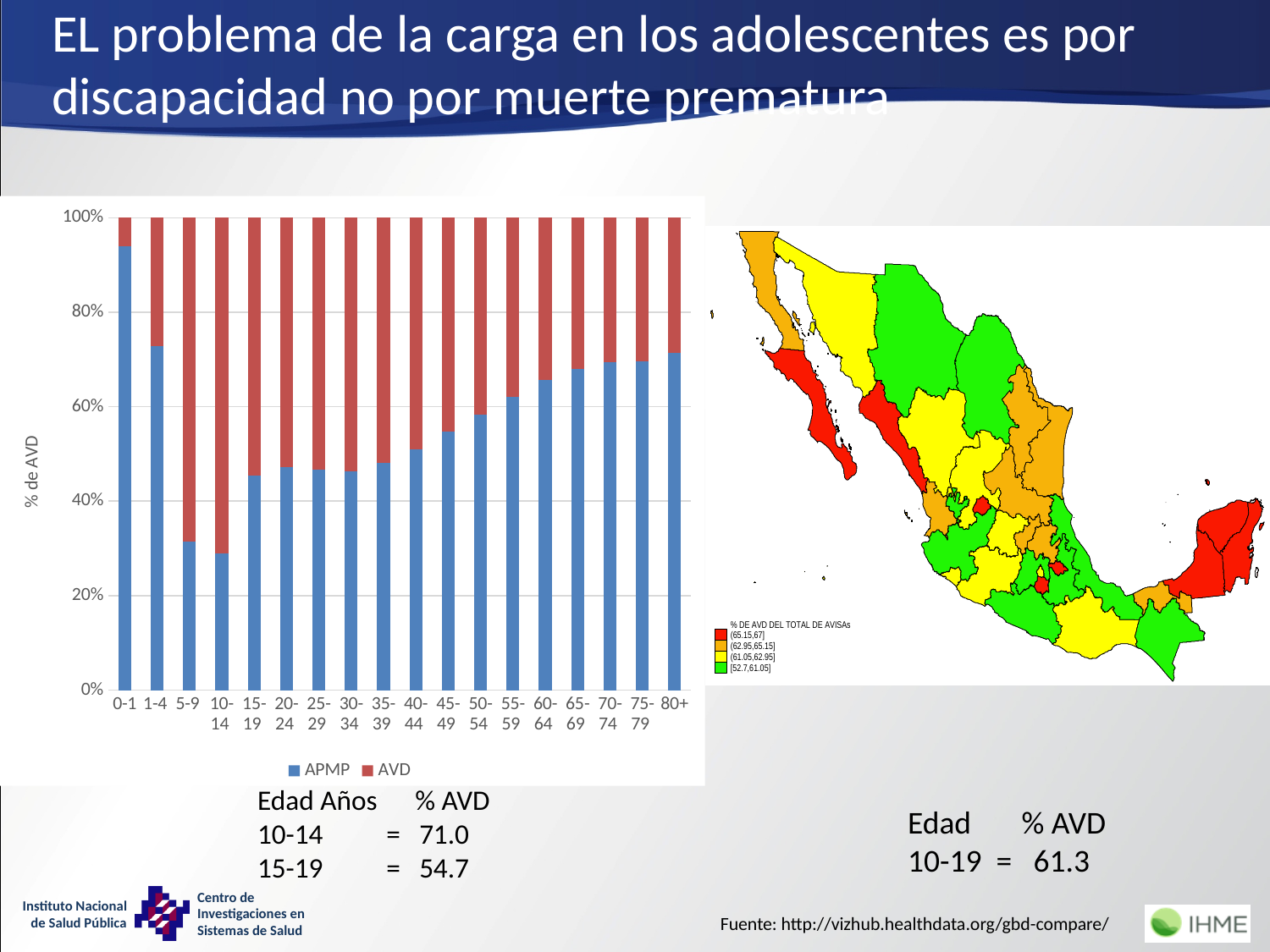
In the bar chart, which age group has the largest APMP (blue) share? 0-1 What are the two series named in the legend of the bar chart? APMP and AVD How many age-group categories are shown on the x axis of the bar chart? 18 In the bar chart, is the APMP (blue) share for the 80+ age group greater or less than 60%? greater In the bar chart, which age group has a larger APMP (blue) share, 0-1 or 1-4? 0-1 In the bar chart, does the APMP (blue) share rise or fall from the 10-14 age group to the 80+ age group? rise In the bar chart, is the APMP (blue) share for the 10-14 age group greater or less than 40%? less How many series does the legend of the bar chart list? 2 What is the label on the y axis of the bar chart? % de AVD In the bar chart, which age group has the smallest APMP (blue) share? 10-14 What kind of chart is shown on the left of the slide? stacked bar chart In the bar chart, is the APMP (blue) share for the 0-1 age group greater or less than 80%? greater